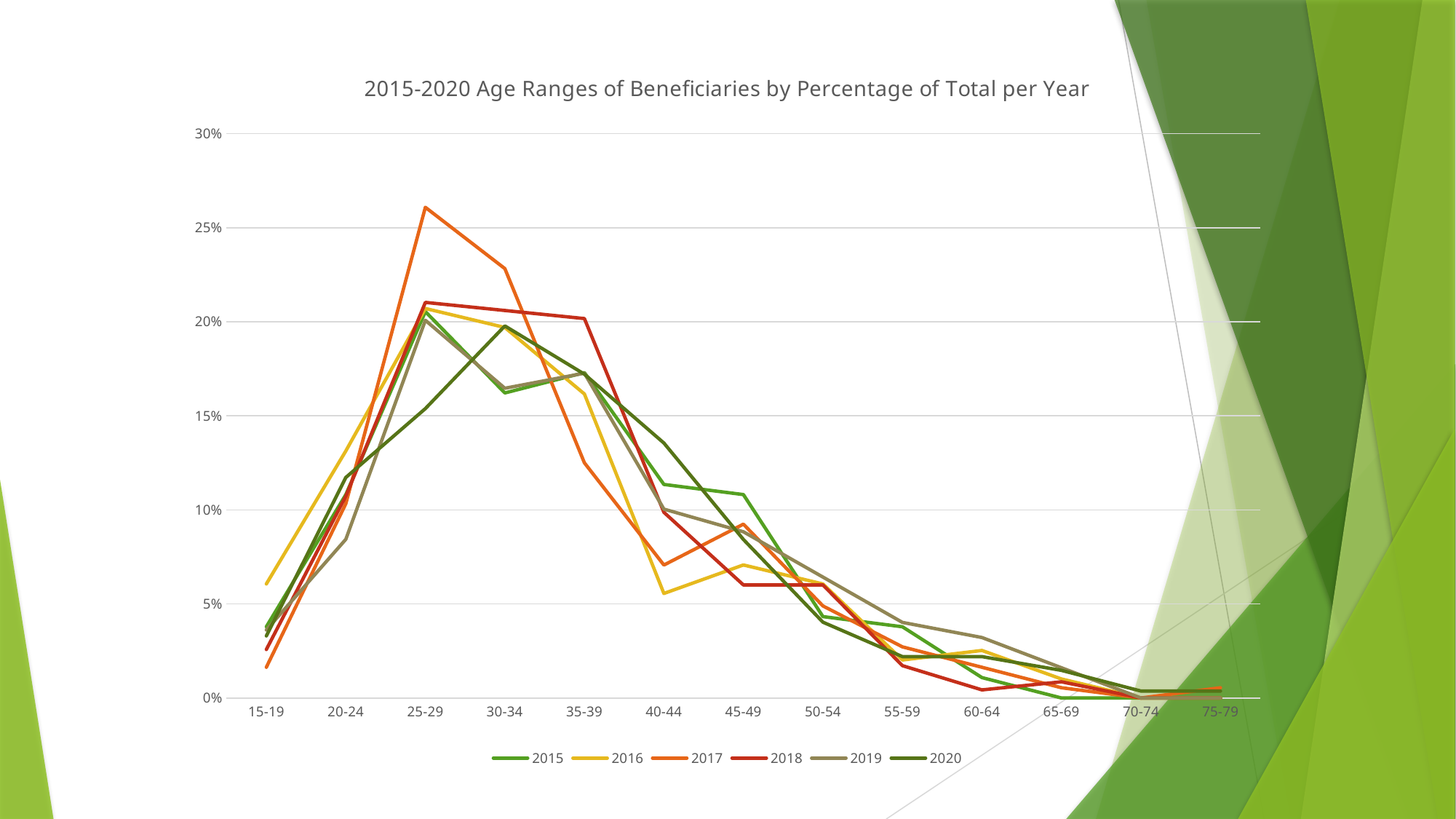
Is the value for 2016 at 15-19 greater or less than 5%? greater Which year has the highest value at the 25-29 age range? 2017 Is the value for 2017 at 25-29 greater or less than 25%? greater What kind of chart is shown on the slide? line chart How many series does the legend list? 6 Which is larger at 40-44: the value for 2017 or the value for 2020? 2020 What is the title of the chart? 2015-2020 Age Ranges of Beneficiaries by Percentage of Total per Year How many age-range categories are shown on the x axis? 13 Which year has the lowest value at the 25-29 age range? 2020 Which year has the lowest value at the 15-19 age range? 2017 Does the 2017 line rise or fall from 25-29 to 40-44? fall Which year has the highest value at the 35-39 age range? 2018